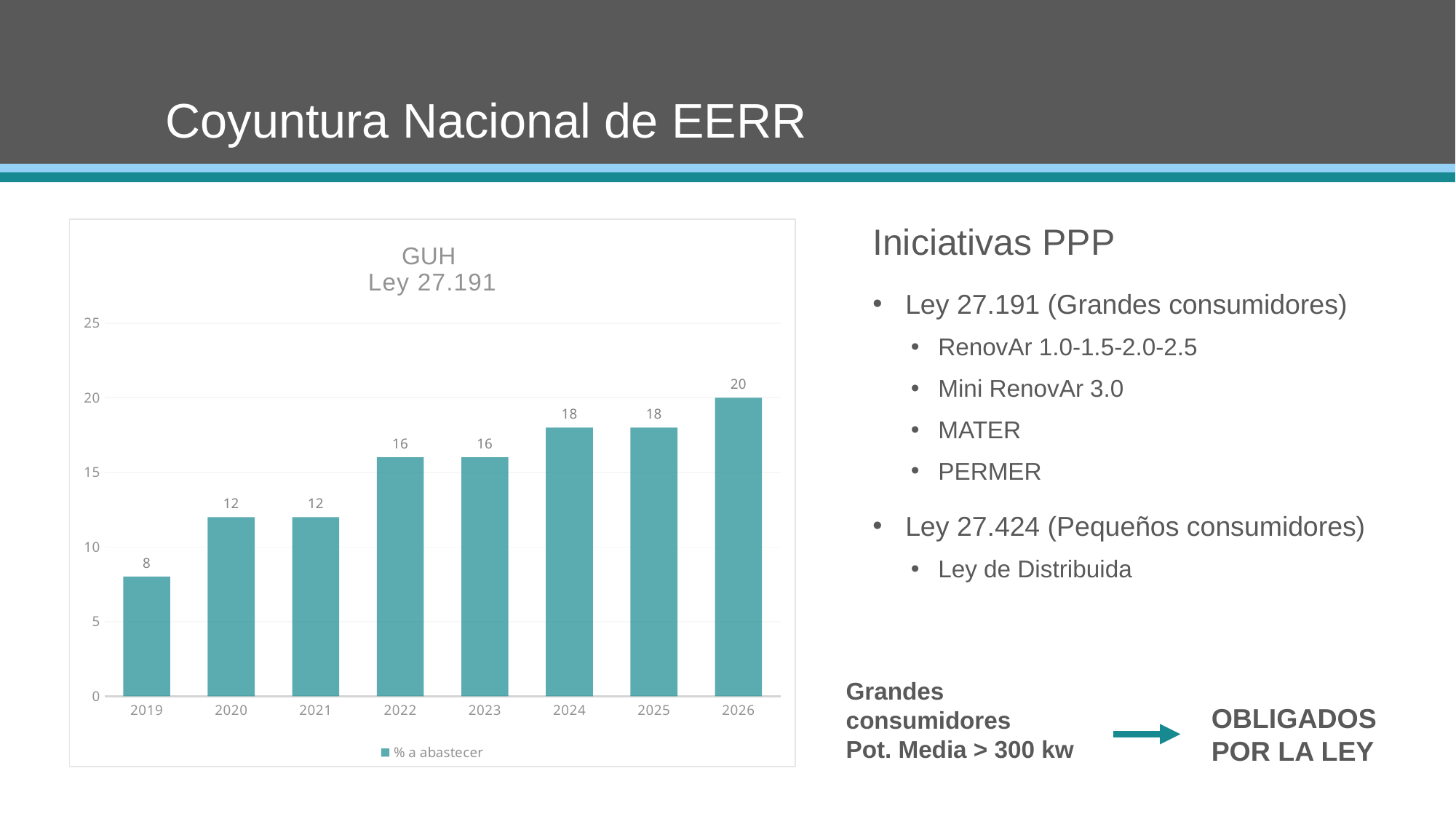
Which is larger in the GUH Ley 27.191 chart, the value for 2020 or the value for 2024? 2024 Which year has the lowest value in the GUH Ley 27.191 chart? 2019 Do the values in the GUH Ley 27.191 chart generally rise or fall from 2019 to 2026? rise Which year has the highest value in the GUH Ley 27.191 chart? 2026 What is the value for 2022 in the GUH Ley 27.191 chart? 16 Is the value for 2025 in the GUH Ley 27.191 chart greater or less than 15? greater What is the difference between the values for 2026 and 2019 in the GUH Ley 27.191 chart? 12 How many series does the legend of the GUH Ley 27.191 chart list? 1 How many years are shown on the x axis of the GUH Ley 27.191 chart? 8 What is the value for 2019 in the GUH Ley 27.191 chart? 8 What kind of chart is the GUH Ley 27.191 chart? bar chart What is the value for 2026 in the GUH Ley 27.191 chart? 20